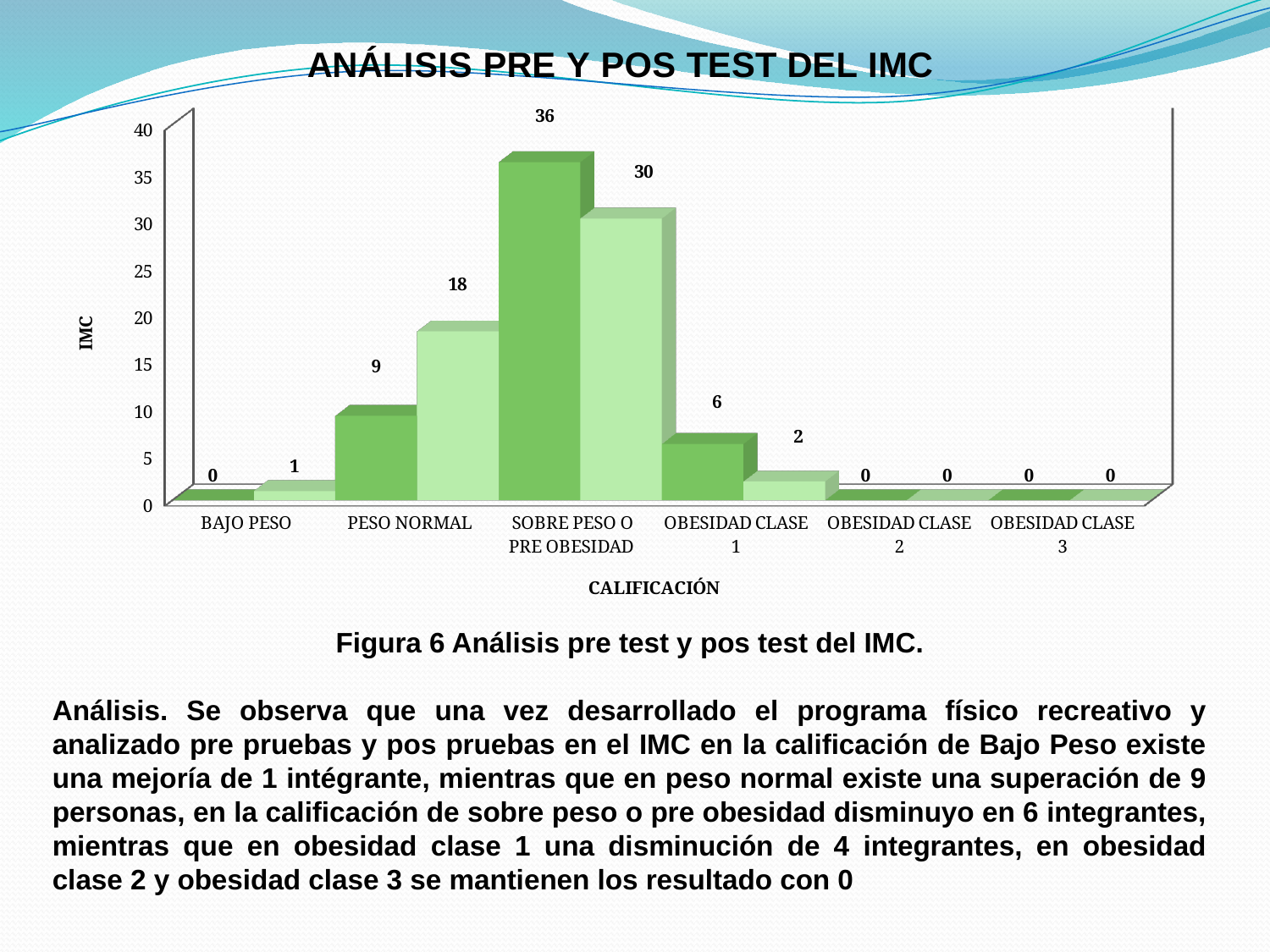
How many categories are shown on the x axis? 6 What is the value of the darker green bar for PESO NORMAL? 9 What is the title of the x axis? CALIFICACIÓN For OBESIDAD CLASE 1, which bar is larger, the darker green or the lighter green? darker green What is the value of the lighter green bar for BAJO PESO? 1 By how much does the darker green bar exceed the lighter green bar for SOBRE PESO O PRE OBESIDAD? 6 What kind of chart is shown on the slide? bar chart What is the difference between the lighter green bar and the darker green bar for PESO NORMAL? 9 What is the value of the lighter green bar for OBESIDAD CLASE 1? 2 Which category has the highest darker green bar? SOBRE PESO O PRE OBESIDAD What is the value of the lighter green bar for SOBRE PESO O PRE OBESIDAD? 30 Is the value of the darker green bar for SOBRE PESO O PRE OBESIDAD greater or less than 35? greater